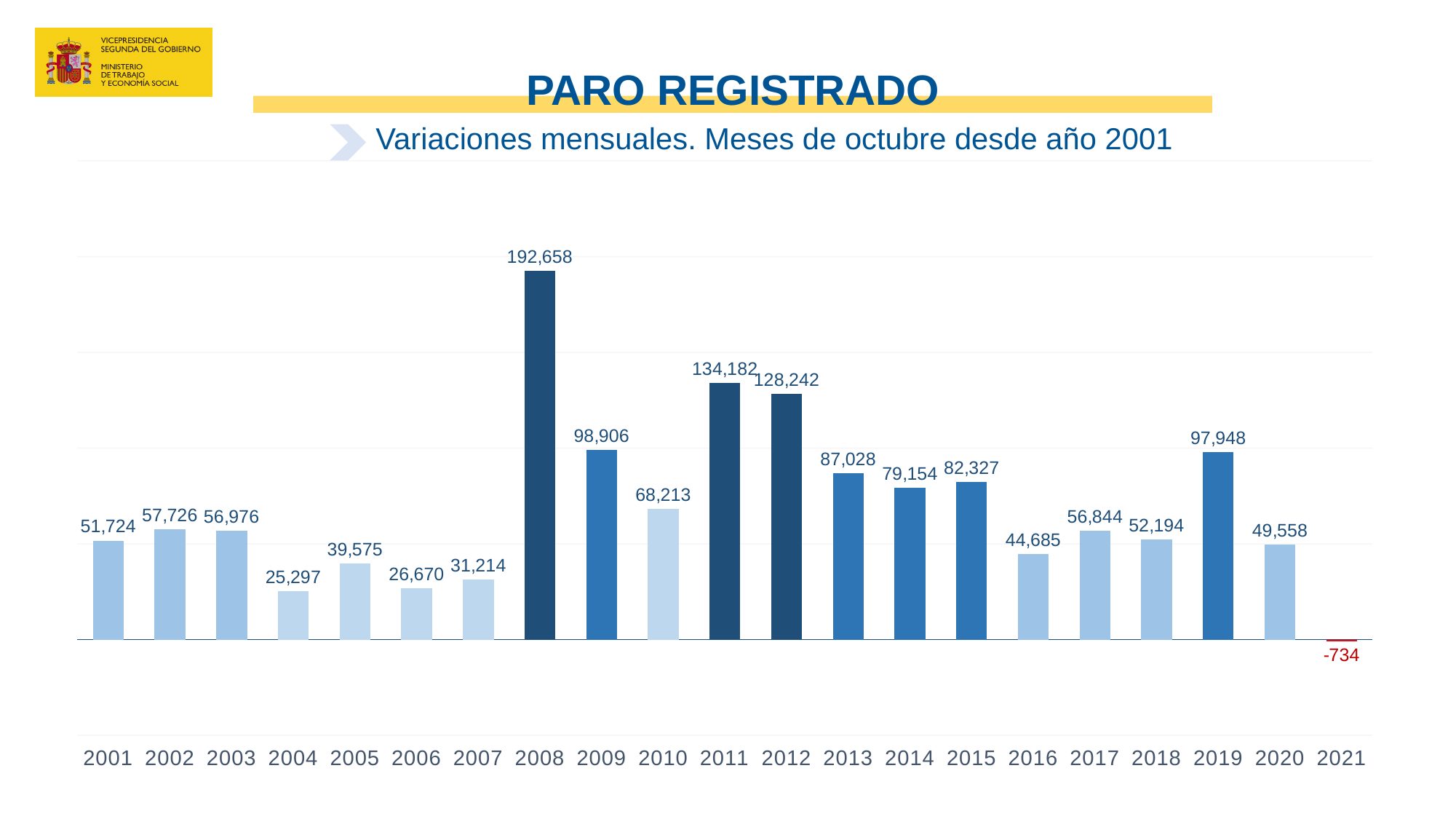
What is the difference between the values for 2019 and 2020? 48,390 Do the values rise or fall from 2011 to 2014? Fall What is the difference between the values for 2008 and 2011? 58,476 What is the value for 2016? 44,685 Which is larger, the value for 2014 or the value for 2015? 2015 What is the value for 2021? -734 Which year has the lowest value? 2021 What is the value for 2008? 192,658 How many years are shown on the x axis? 21 What kind of chart is shown on the slide? Bar chart Which is larger, the value for 2011 or the value for 2012? 2011 Which year has the highest value? 2008